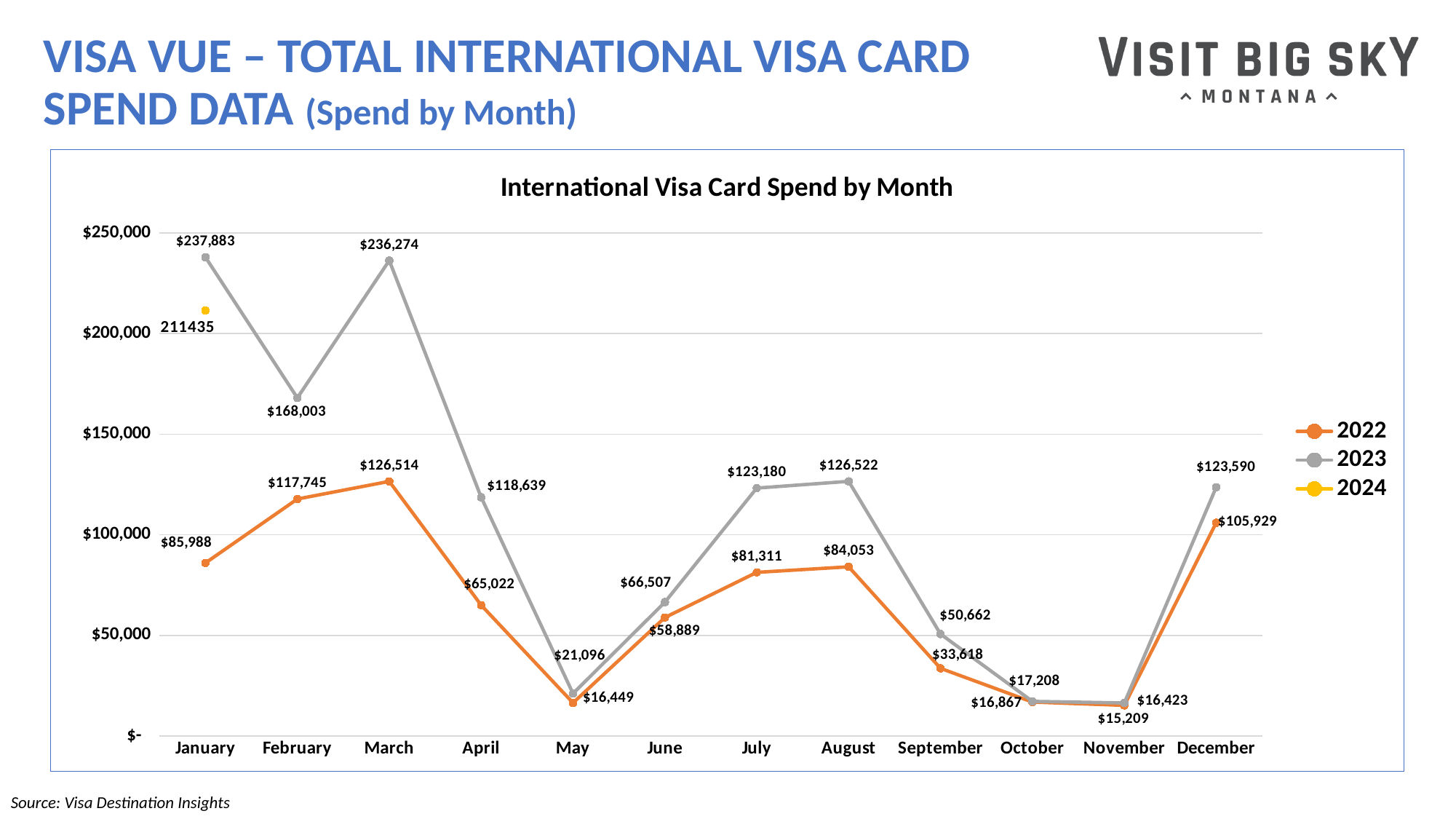
Which month had the lowest spend in the 2022 series? November What was the international Visa card spend in January 2023? $237,883 How many months are shown on the x axis? 12 Does the 2023 spend rise or fall from September to November? fall In the 2022 series, which month had the larger spend, July or August? August Is the 2023 spend for February greater or less than $150,000? greater What is the difference between the 2023 and 2022 spend in August? $42,469 What value is shown for the 2024 series in January? 211435 What was the 2022 spend in December? $105,929 How many series does the legend list? 3 What kind of chart is shown on the slide? line chart Which month had the highest spend in the 2022 series? March